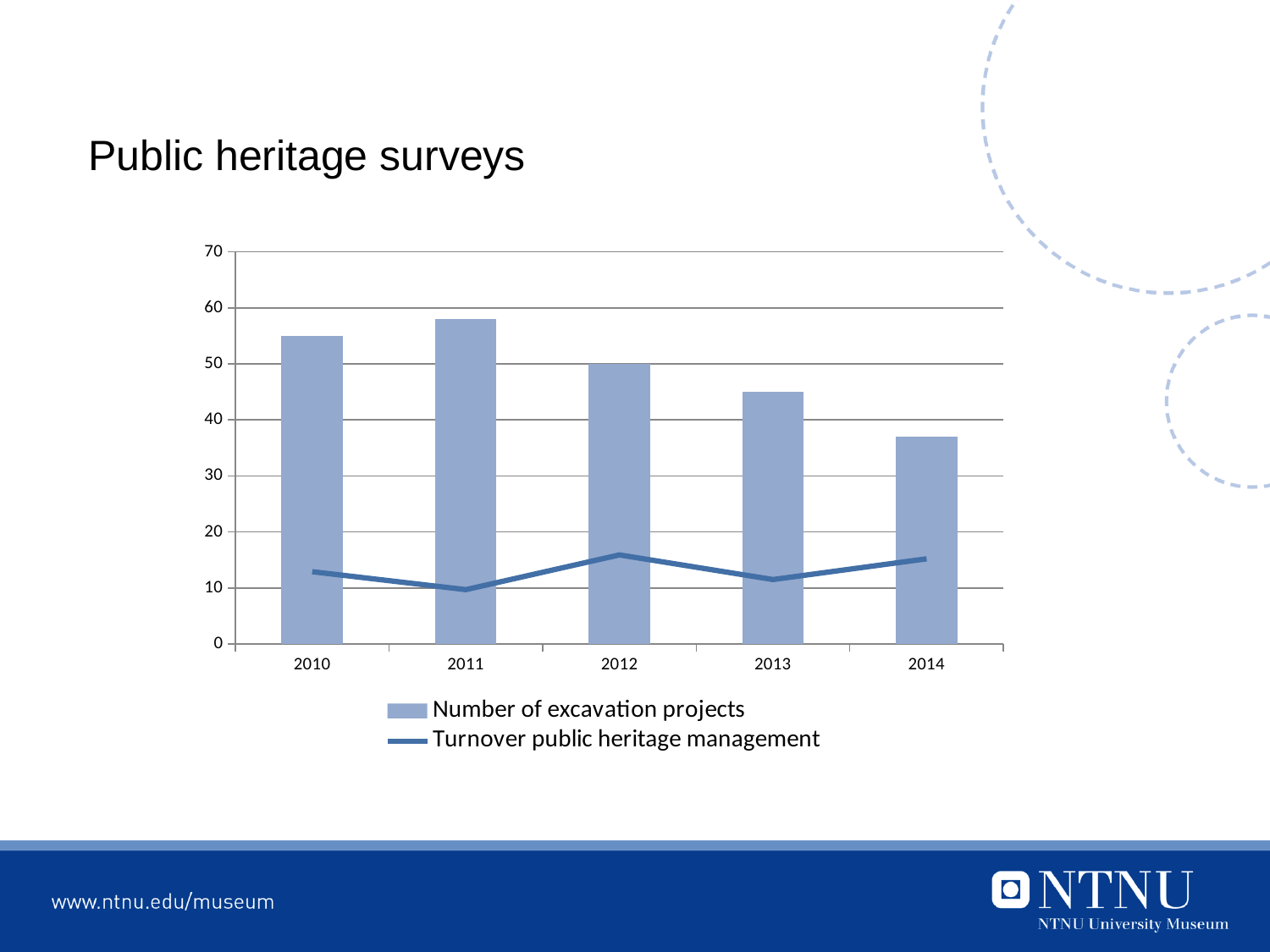
Which year has more excavation projects, 2010 or 2013? 2010 How many series does the legend list? 2 In which year is the number of excavation projects highest? 2011 Is the turnover public heritage management value in 2012 greater or less than 20? less Does the number of excavation projects rise or fall from 2011 to 2014? fall Which series is drawn as a line rather than bars? Turnover public heritage management Is the number of excavation projects in 2014 greater or less than 40? less What is the title of the slide containing the chart? Public heritage surveys How many years are shown on the x axis? 5 In which year is the number of excavation projects lowest? 2014 Is the number of excavation projects in 2010 greater or less than 50? greater